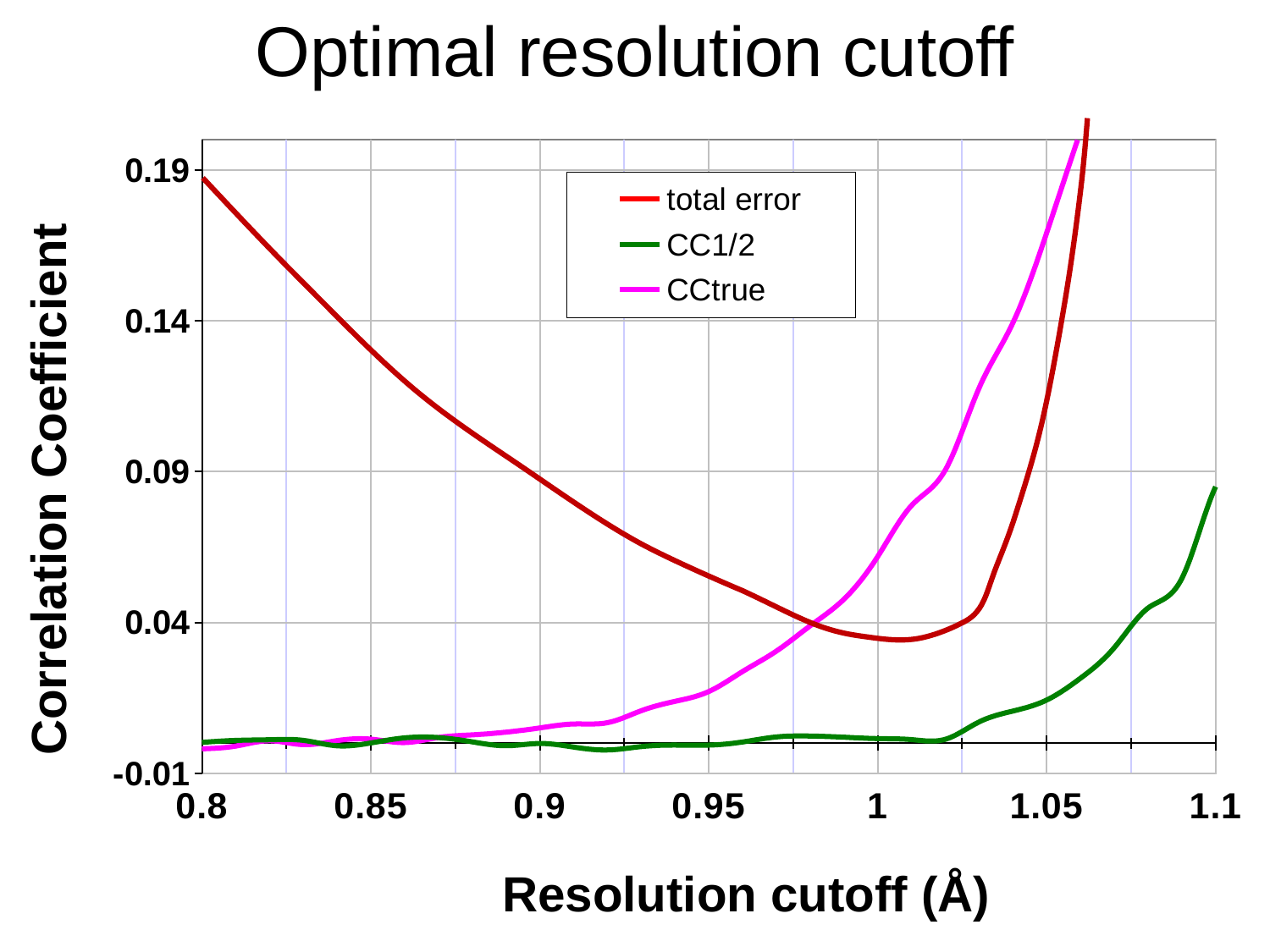
At a resolution cutoff of 0.9, which series has the larger value, total error or CCtrue? total error Is the value of total error at a resolution cutoff of 0.95 greater or less than 0.04? greater Which series has the lowest value at a resolution cutoff of 1.05? CC1/2 Is the value of CCtrue at a resolution cutoff of 1.05 greater or less than 0.14? greater At a resolution cutoff of 1.05, which series has the larger value, CCtrue or total error? CCtrue Is the value of total error at a resolution cutoff of 0.85 greater or less than 0.14? less What is the label of the x axis? Resolution cutoff (Å) How many series does the legend list? 3 What kind of chart is shown on the slide? line chart Does the CCtrue series generally rise or fall as the resolution cutoff increases from 0.8 to 1.05? rise What is the title of the chart? Optimal resolution cutoff